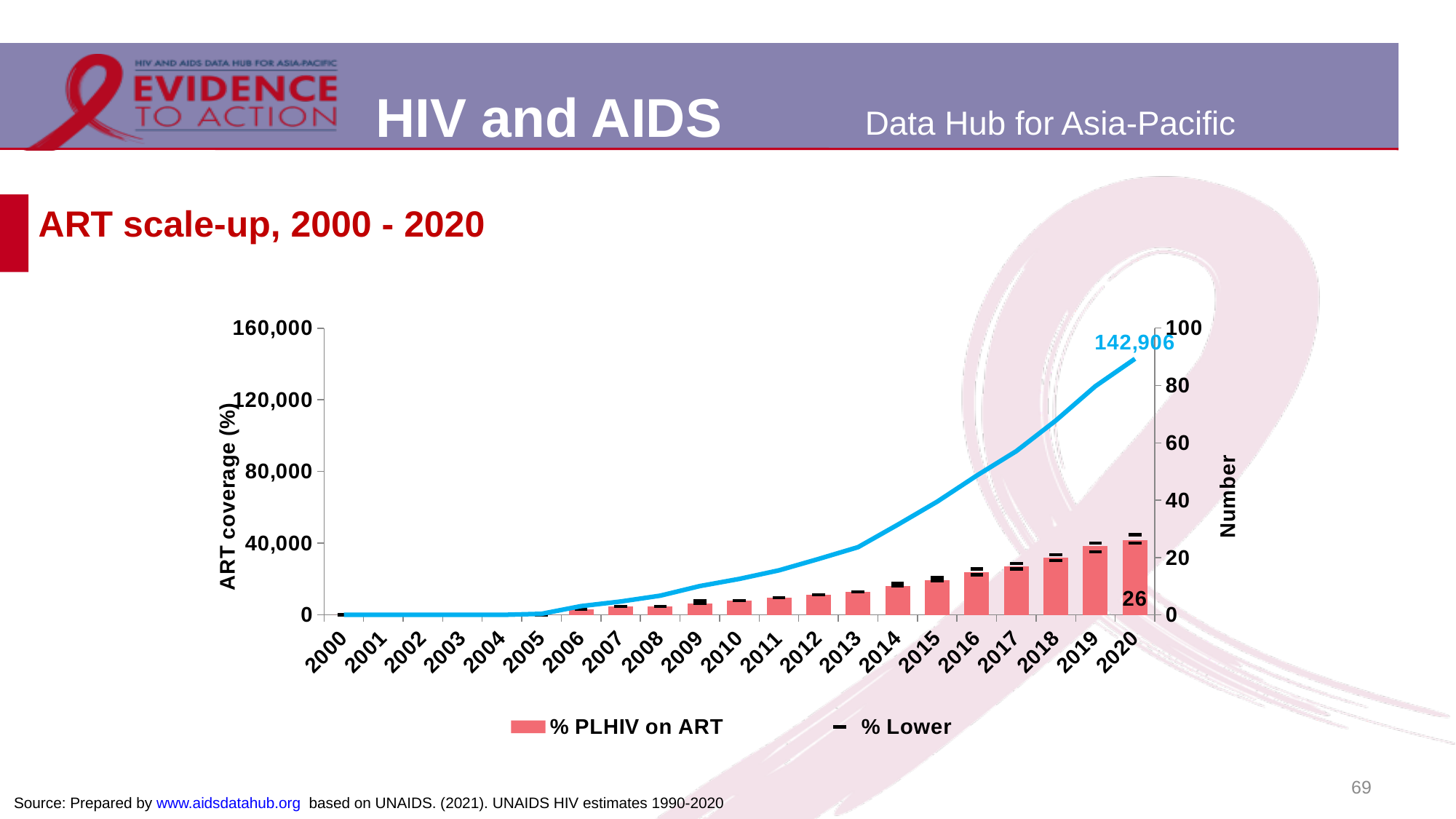
How many entries does the legend list? 2 What is the value of % PLHIV on ART for 2020, as labelled on the bar? 26 Which year has the larger % PLHIV on ART bar, 2010 or 2019? 2019 Is the % PLHIV on ART bar for 2013 greater or less than 20 on the right axis? less What is the second legend entry, shown with a black dash marker? % Lower Do the % PLHIV on ART bars rise or fall from 2000 to 2020? Rise What kind of chart is this? Combined bar and line chart What is the data label shown on the blue line for 2020? 142,906 Is the blue line value for 2015 greater or less than 40,000 on the left axis? greater Which year has the highest % PLHIV on ART bar? 2020 What is the title of the chart? ART scale-up, 2000 - 2020 How many years are shown along the x axis? 21